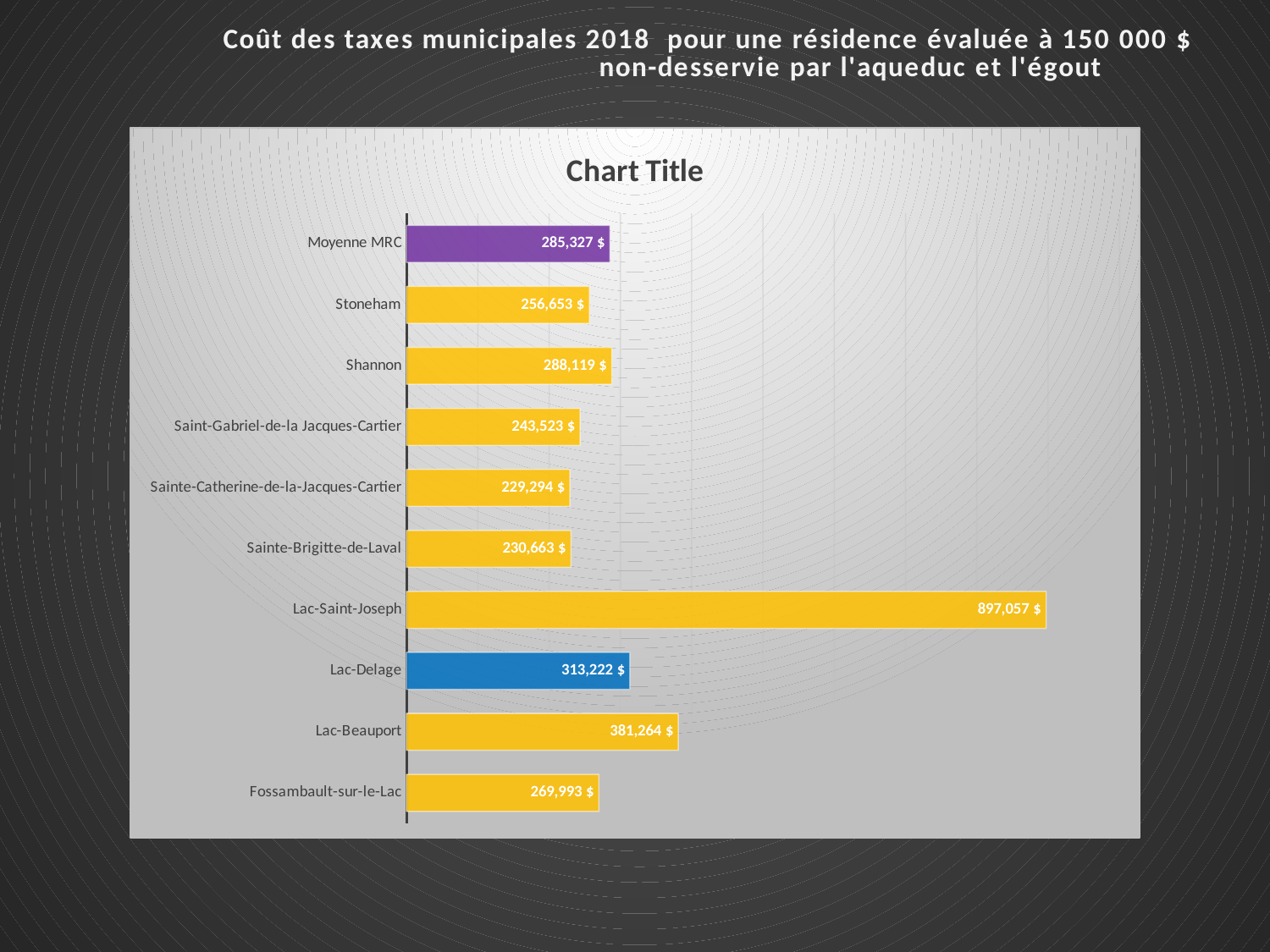
How many categories are shown on the chart? 10 What is the value shown for Lac-Delage? 313,222 $ Which is larger, the value for Shannon or the value for Stoneham? Shannon What is the difference between the values for Lac-Beauport and Lac-Delage? 68,042 $ What is the difference between the values for Lac-Saint-Joseph and Lac-Beauport? 515,793 $ Which category has the highest value? Lac-Saint-Joseph What is the value shown for Moyenne MRC? 285,327 $ What is the value shown for Lac-Saint-Joseph? 897,057 $ What colour is the bar for Lac-Delage? Blue Which category has the lowest value? Sainte-Catherine-de-la-Jacques-Cartier What is the value shown for Sainte-Brigitte-de-Laval? 230,663 $ What kind of chart is shown on the slide? Bar chart